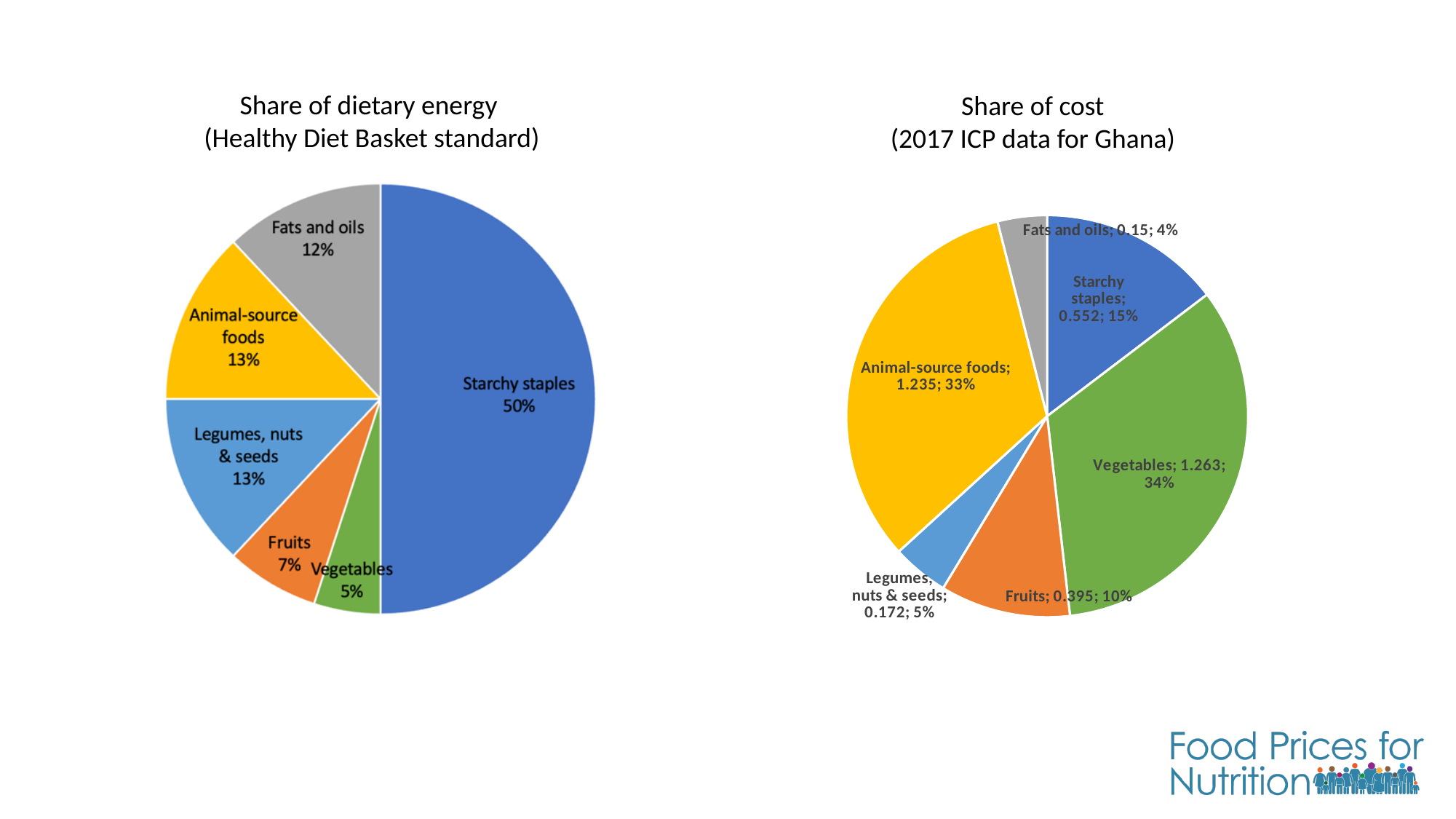
In the 'Share of dietary energy' chart, what share do Starchy staples have? 50% In the 'Share of cost' chart, what is the cost value for Legumes, nuts & seeds? 0.172 In the 'Share of cost' chart, what is the cost value for Vegetables? 1.263 In the 'Share of cost' chart, which is larger, the share for Starchy staples or the share for Fruits? Starchy staples In the 'Share of dietary energy' chart, what share do Fats and oils have? 12% In the 'Share of cost' chart, what percentage share do Animal-source foods have? 33% What type of chart is used on the left of the slide? Pie chart In the 'Share of dietary energy' chart, what is the difference between the shares of Starchy staples and Fruits? 43% In the 'Share of dietary energy' chart, which category has the smallest share? Vegetables What is the title of the chart on the right of the slide? Share of cost (2017 ICP data for Ghana) In the 'Share of dietary energy' chart, how many categories are shown? 6 In the 'Share of cost' chart, which category has the smallest share? Fats and oils